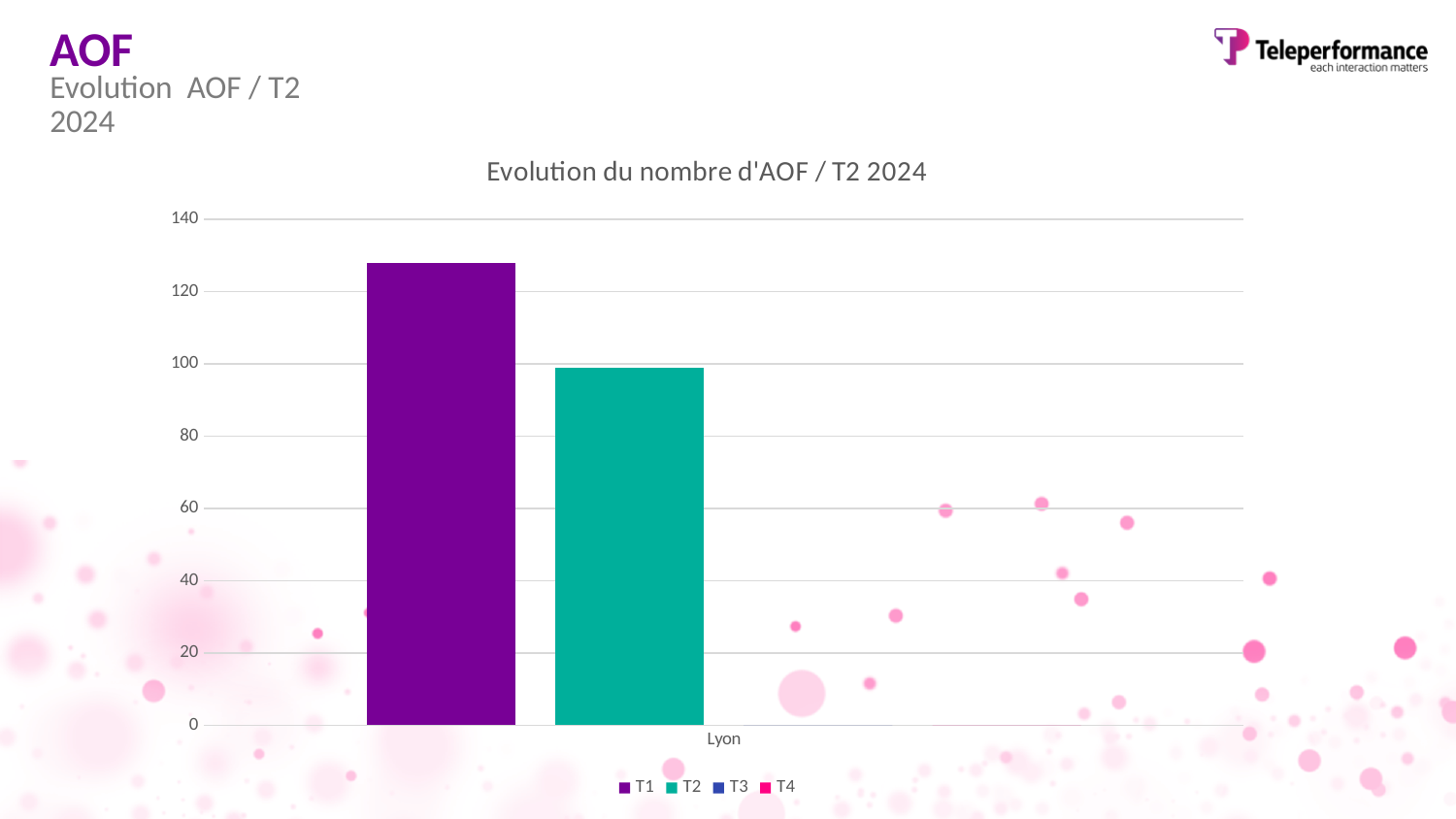
Is the value for T2 in Lyon greater or less than 120? less How many categories are shown on the x axis? 1 Is the value for T2 in Lyon greater or less than 80? greater What type of chart is shown on the slide? bar chart Which is larger for Lyon, the T1 bar or the T2 bar? T1 What is the title of the chart? Evolution du nombre d'AOF / T2 2024 Which category is shown on the x axis? Lyon Is the value for T1 in Lyon greater or less than 140? less How many series does the legend list? 4 Which series has the highest bar for Lyon? T1